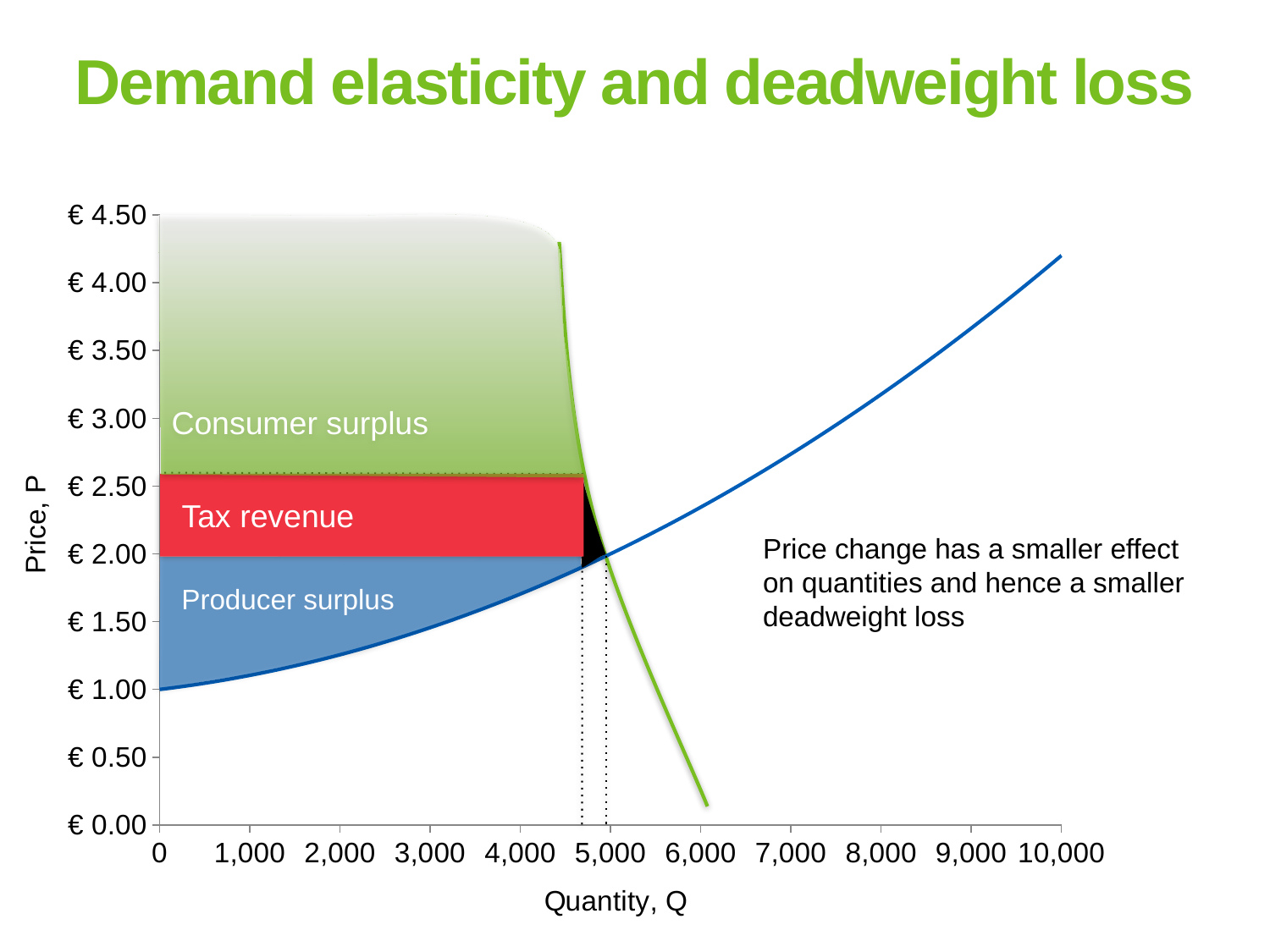
What is the label of the horizontal axis? Quantity, Q What is the price on the blue supply curve at a quantity of 0? € 1.00 Is the price on the green demand curve at a quantity of 6,000 greater or less than € 0.50? less Does the blue supply curve rise or fall as quantity increases? rises What is the title of the slide's chart? Demand elasticity and deadweight loss Is the price on the blue supply curve at a quantity of 10,000 greater or less than € 4.00? greater How many labelled shaded regions are there on the chart? 3 Is the quantity where the supply and demand curves intersect greater or less than 4,000? greater What is the highest price tick shown on the vertical axis? € 4.50 What kind of chart is shown on the slide? line chart How many curves are plotted on the chart? 2 What is the label of the vertical axis? Price, P